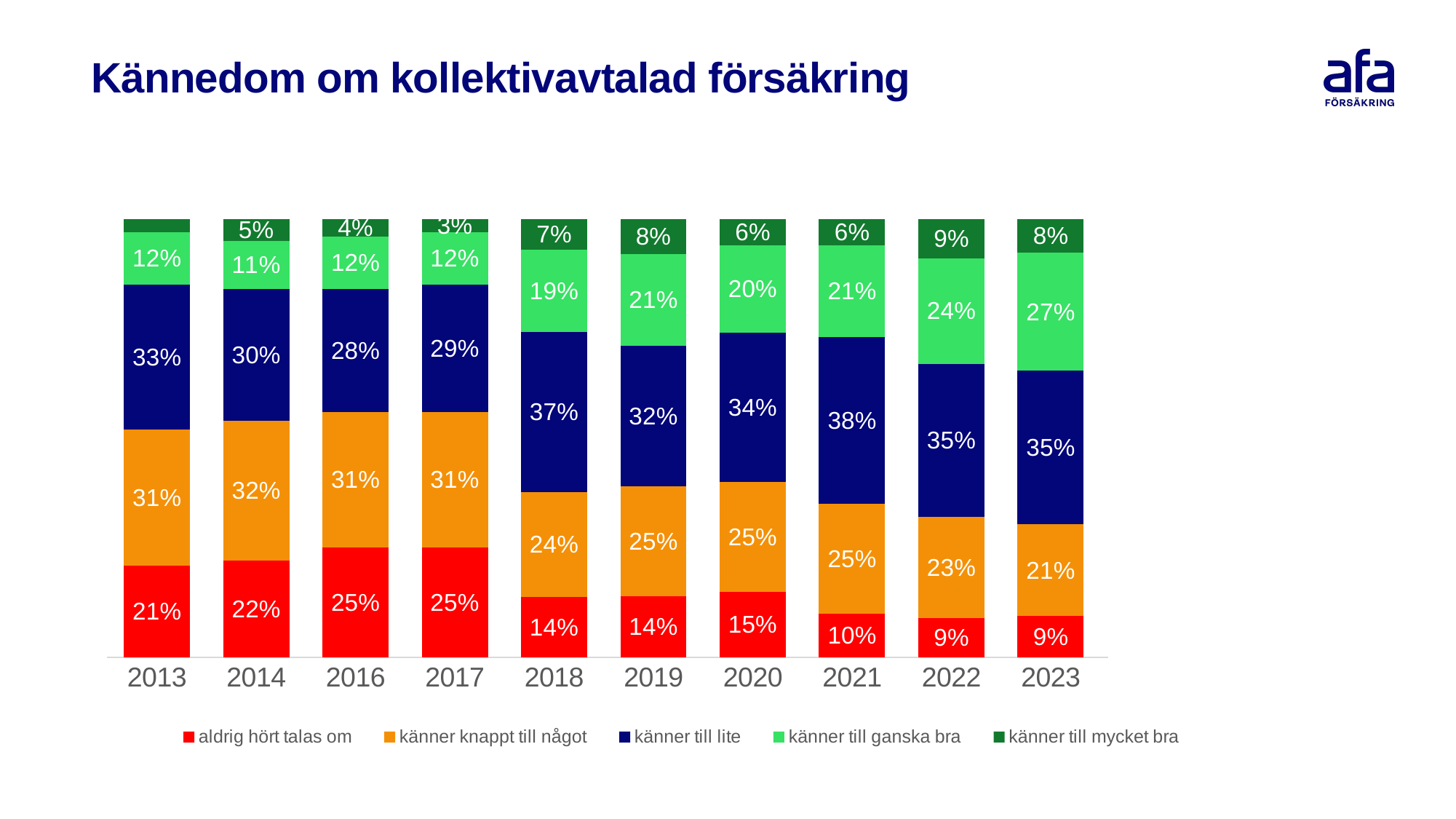
How many percentage points higher is "känner till ganska bra" in 2023 than in 2013? 15 What colour represents "aldrig hört talas om" in the chart? Red What is the value for "känner till mycket bra" in 2022? 9% What kind of chart is shown on the slide? Stacked bar chart Does the "känner till ganska bra" share generally rise or fall from 2017 to 2023? Rise What is the value for "aldrig hört talas om" in 2013? 21% How many years are shown on the x axis? 10 How many series does the legend list? 5 What is the value for "känner till ganska bra" in 2023? 27% Which year has the larger value for "känner knappt till något", 2014 or 2023? 2014 In which year is the "känner till lite" share highest? 2021